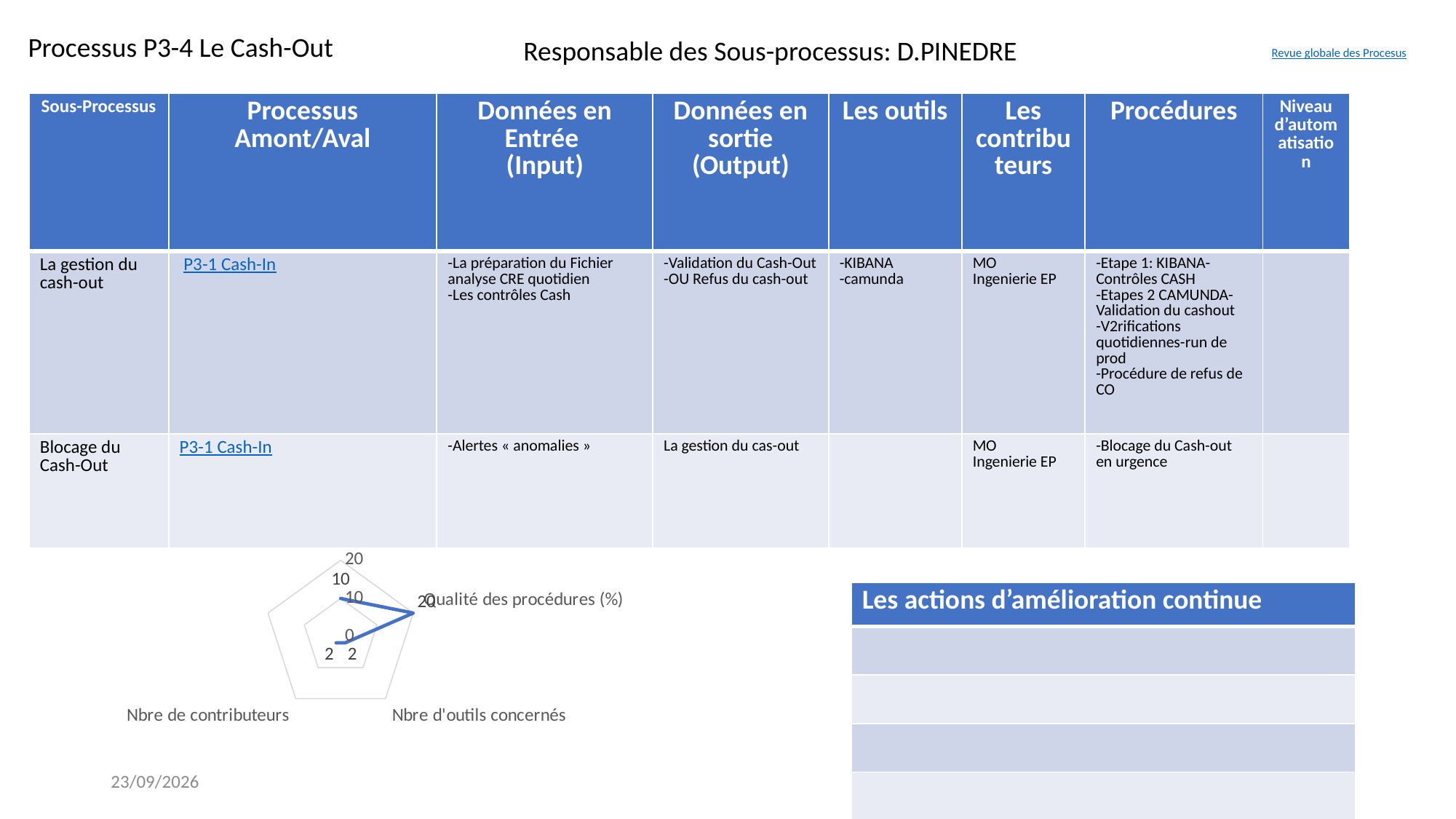
Which category label appears at the bottom left of the radar chart? Nbre de contributeurs What is the highest tick value shown on the radar chart's axis? 20 In the radar chart, what is the value for Qualité des procédures (%)? 20 What kind of chart is shown at the bottom left of the slide? radar chart In the radar chart, is the value for Nbre d'outils concernés greater or less than 10? less In the radar chart, which category has the highest value? Qualité des procédures (%) In the radar chart, is the value for Nbre de contributeurs greater or less than 10? less In the radar chart, which is larger: the value for Qualité des procédures (%) or the value for Nbre d'outils concernés? Qualité des procédures (%)